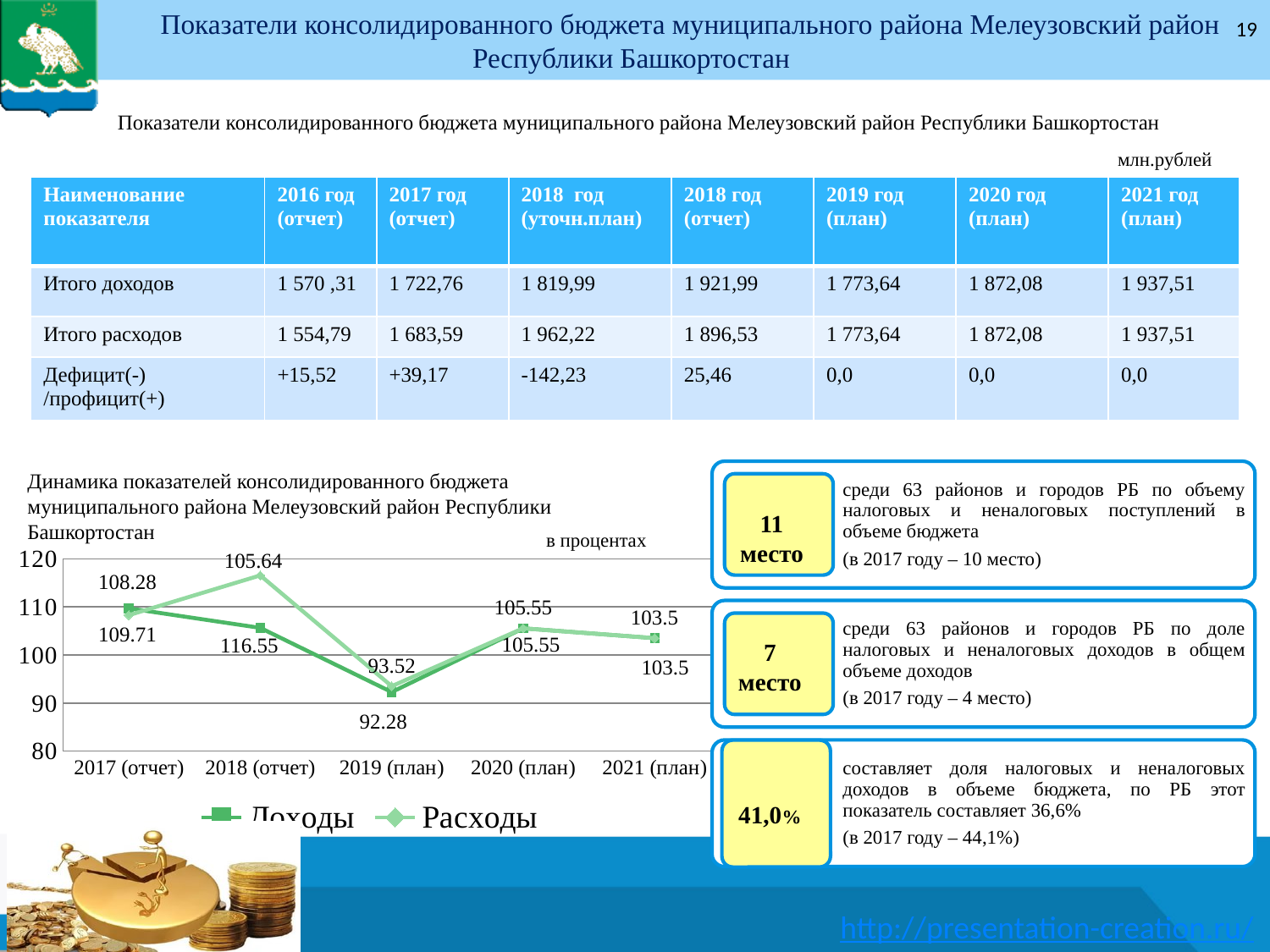
What kind of chart is shown on the slide? line chart What unit label is shown above the chart's plot area? в процентах What is the value for Доходы in 2020 (план)? 105.55 Is the value for Расходы in 2019 (план) greater or less than 100? less In which category does the Расходы series reach its highest value? 2018 (отчет) Is the value for Расходы in 2018 (отчет) greater or less than 110? greater In which category does the Доходы series reach its lowest value? 2019 (план) What is the value for Расходы in 2021 (план)? 103.5 How many series does the chart legend list? 2 At 2018 (отчет), which series is higher, Доходы or Расходы? Расходы How many categories are shown on the x axis of the chart? 5 What are the two series named in the chart legend? Доходы and Расходы